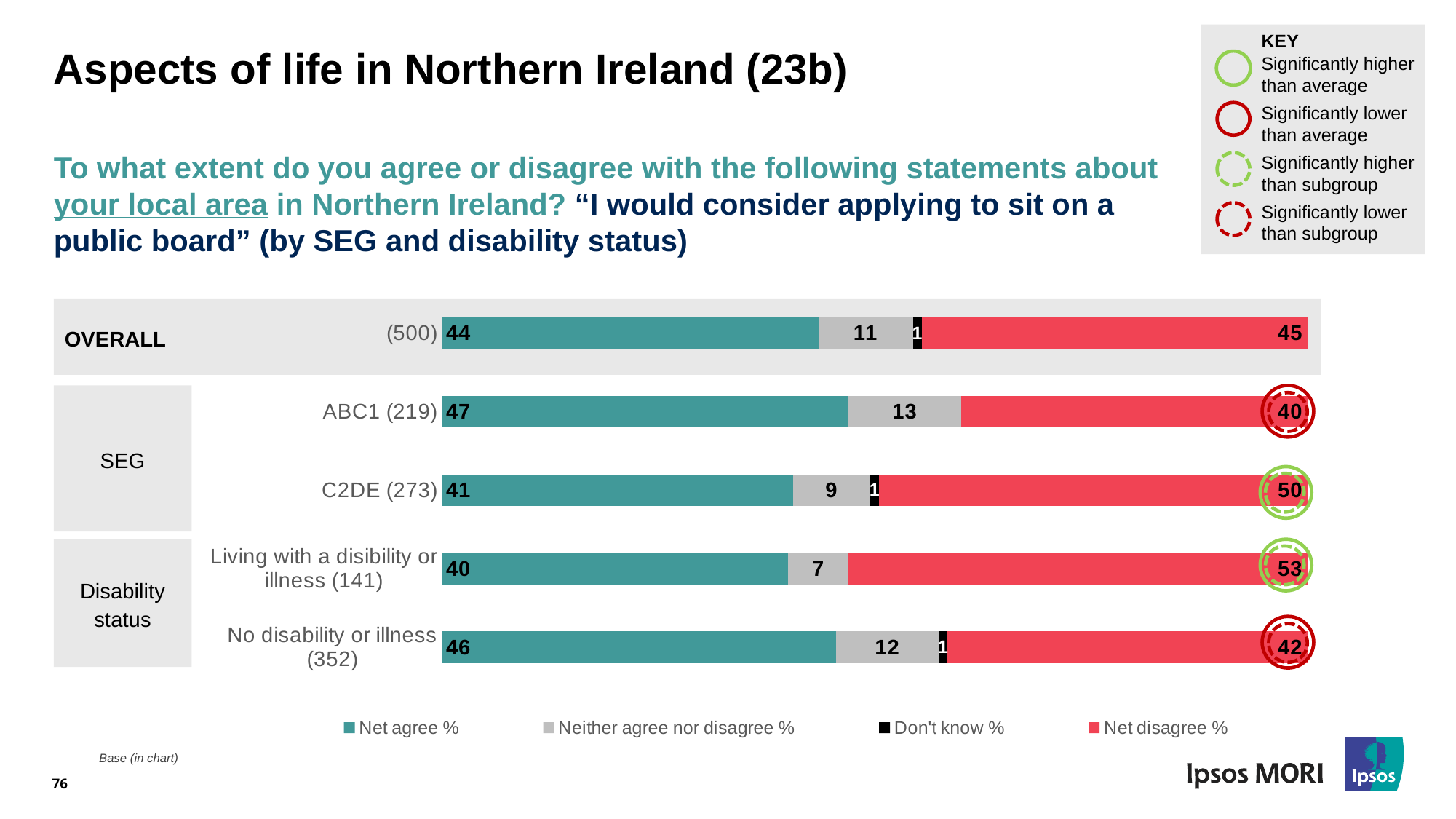
What is the base size shown for the C2DE category? 273 Which category has the highest Net agree %? ABC1 Which is larger, the Net agree % for No disability or illness or for Living with a disability or illness? No disability or illness Which category has the lowest Net disagree %? ABC1 What is the Net disagree % for Living with a disability or illness? 53 What is the Net agree % for OVERALL? 44 How many series does the legend list? 4 What is the difference between the Net disagree % for C2DE and ABC1? 10 What kind of chart is shown on the slide? Stacked bar chart What is the Don't know % for C2DE? 1 What is the Neither agree nor disagree % for ABC1? 13 How many categories (bars) are shown in the chart? 5